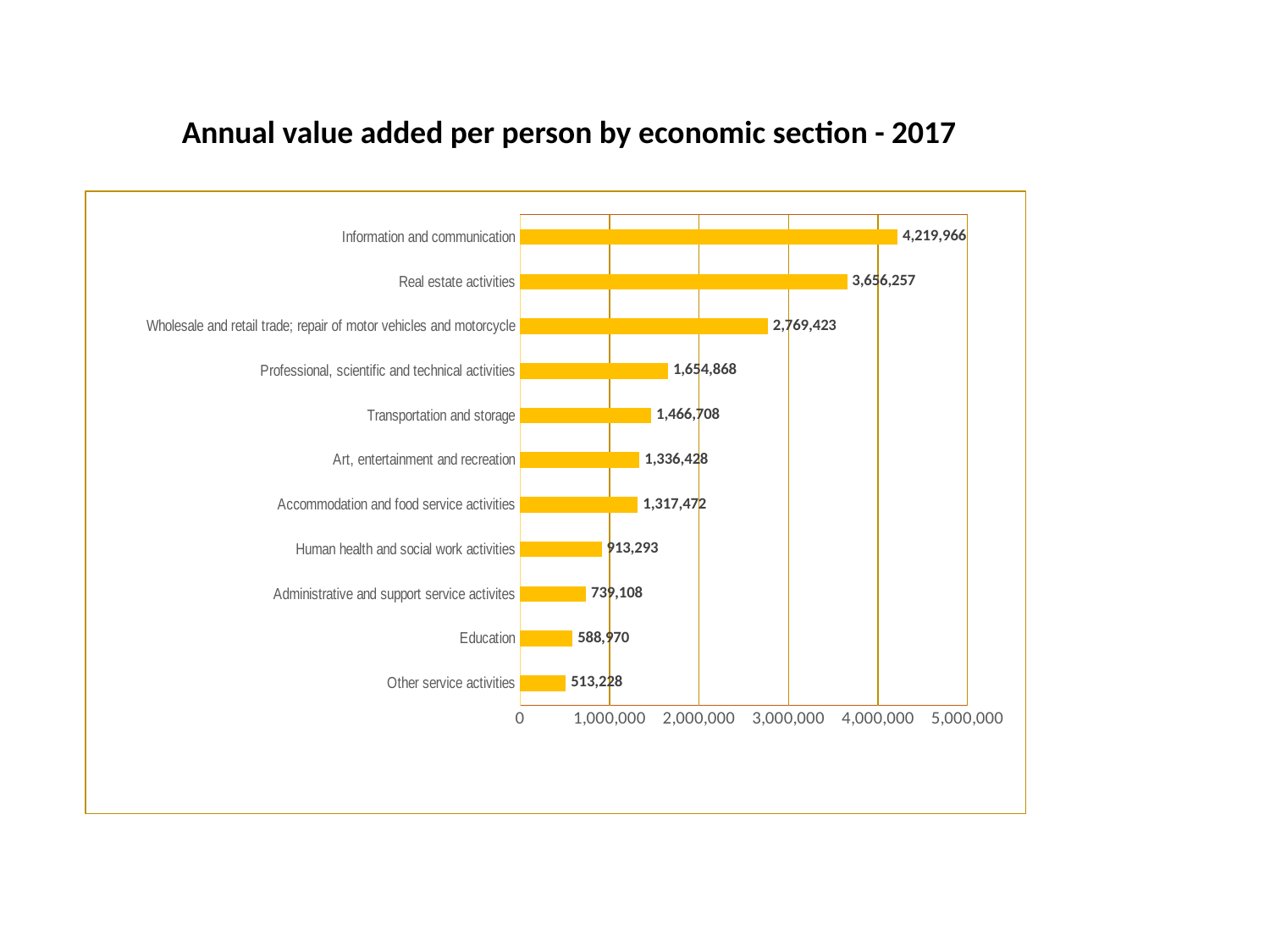
What is the annual value added per person for Information and communication? 4,219,966 What colour are the bars in the chart? Yellow What is the value shown for Transportation and storage? 1,466,708 What is the title of the chart? Annual value added per person by economic section - 2017 What is the difference between the values for Information and communication and Real estate activities? 563,709 What kind of chart is shown on the slide? Bar chart How many economic sections are shown in the chart? 11 Which is larger: the value for Human health and social work activities or the value for Administrative and support service activites? Human health and social work activities Which economic section has the highest annual value added per person? Information and communication What is the value shown for Education? 588,970 Is the value for Wholesale and retail trade; repair of motor vehicles and motorcycle greater or less than 2,000,000? greater Which economic section has the lowest annual value added per person? Other service activities